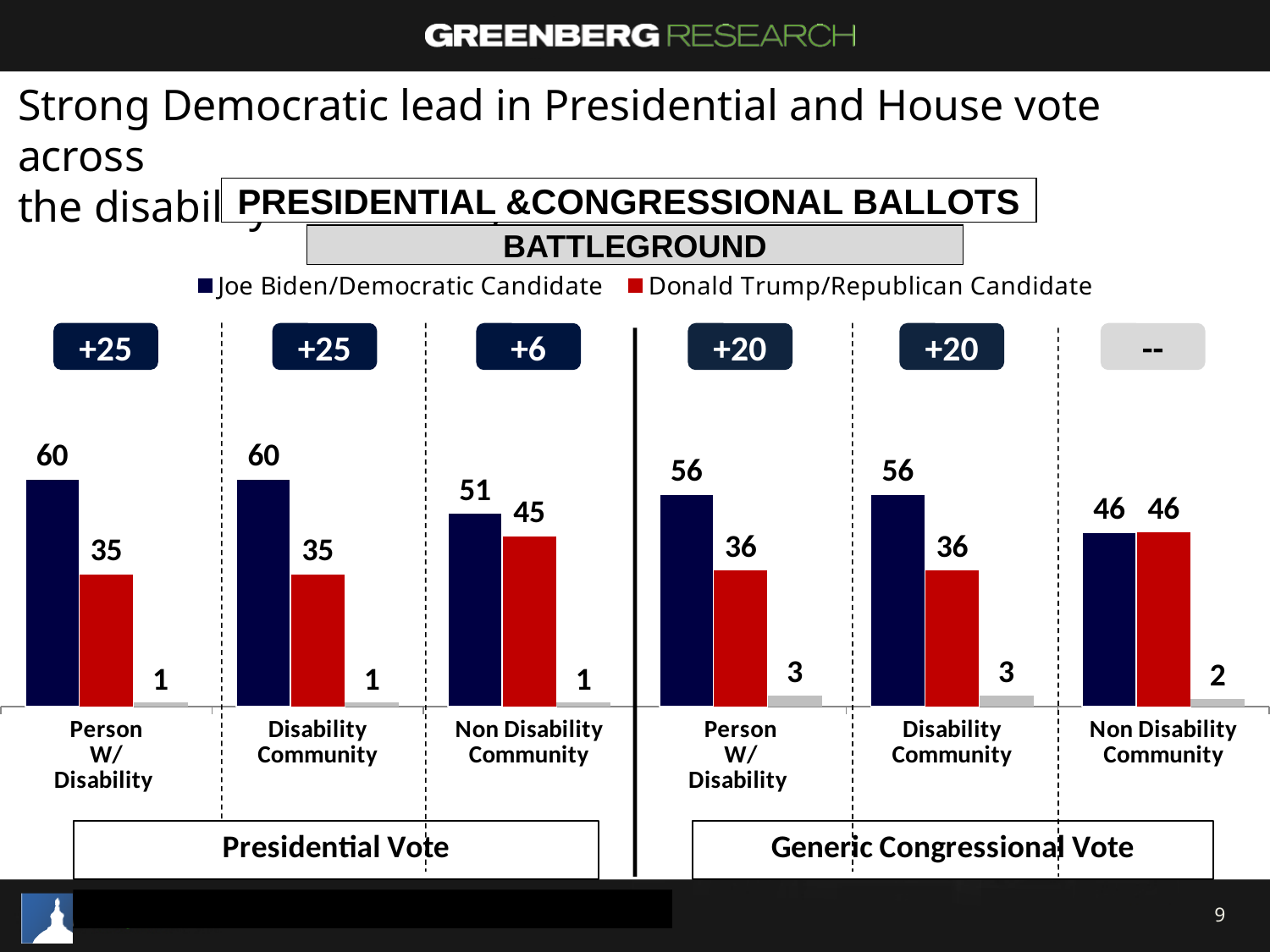
What is the title shown above the chart? PRESIDENTIAL & CONGRESSIONAL BALLOTS In the Presidential Vote section, which is larger for the Non Disability Community: the Joe Biden/Democratic Candidate value or the Donald Trump/Republican Candidate value? Joe Biden/Democratic Candidate In the Generic Congressional Vote section, what is the difference between the Joe Biden/Democratic Candidate and Donald Trump/Republican Candidate values for Person W/ Disability? 20 In the Presidential Vote section, what is the value for Joe Biden/Democratic Candidate among Person W/ Disability? 60 How many series does the legend list? 2 In the Generic Congressional Vote section, what is the value for Donald Trump/Republican Candidate among the Disability Community? 36 How many groups are shown on the x axis across both sections of the chart? 6 In the Presidential Vote section, what is the value for Donald Trump/Republican Candidate among the Non Disability Community? 45 What kind of chart is shown on the slide? bar chart In the Presidential Vote section, which group has the lowest value for Joe Biden/Democratic Candidate? Non Disability Community In the Generic Congressional Vote section, what is the value for Joe Biden/Democratic Candidate among the Non Disability Community? 46 In the Presidential Vote section, what is the difference between the Joe Biden/Democratic Candidate and Donald Trump/Republican Candidate values for the Disability Community? 25